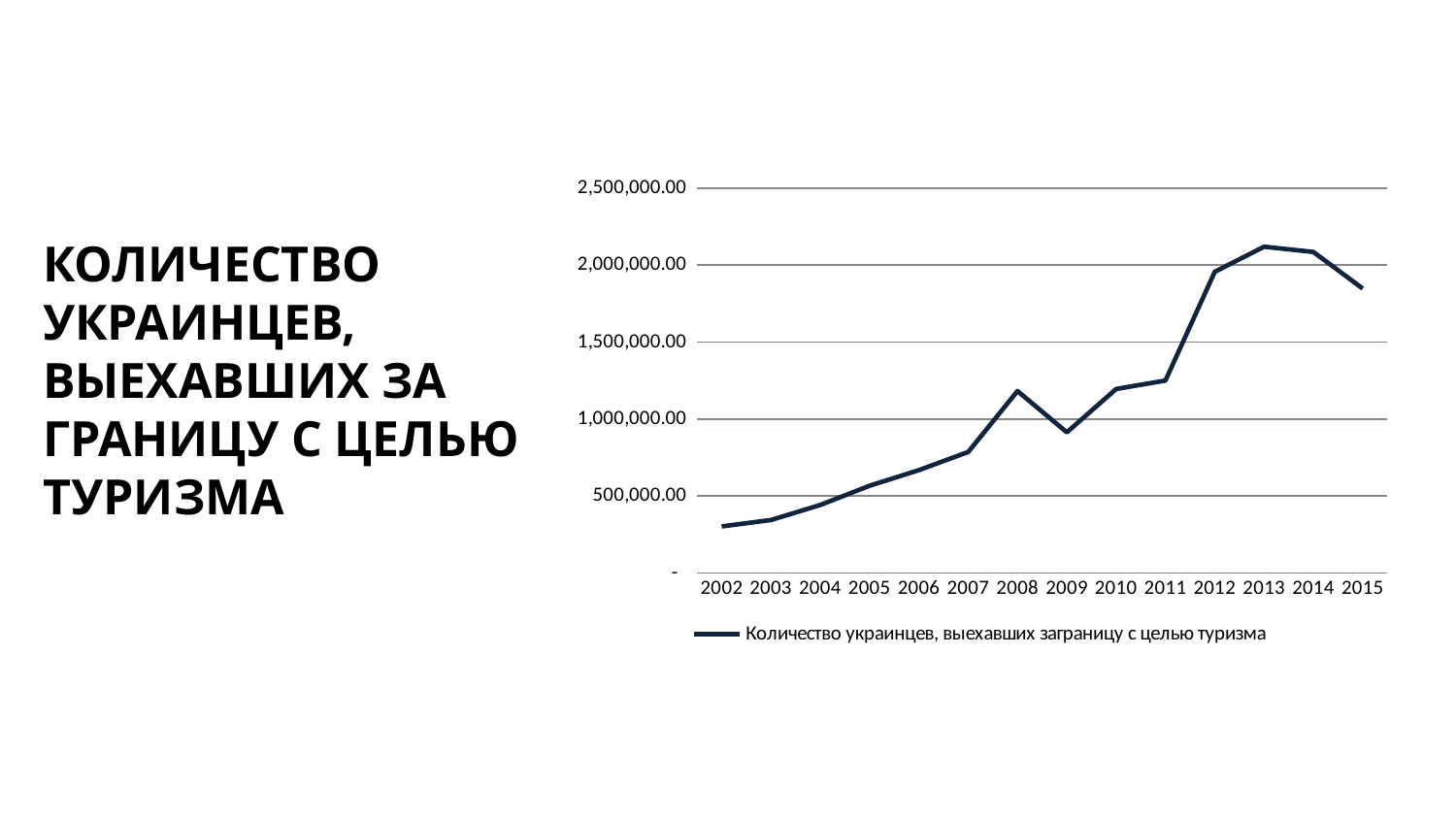
Is the value for 2008 greater or less than 1,000,000.00? greater Is the value for 2015 greater or less than 2,000,000.00? less Which year has the lowest value on the chart? 2002 What kind of chart is shown on the slide? line chart Is the value for 2002 greater or less than 500,000.00? less What is the legend entry for the plotted series? Количество украинцев, выехавших заграницу с целью туризма How many series does the chart's legend list? 1 Does the value generally rise or fall from 2002 to 2013? rise Which year has the larger value, 2008 or 2009? 2008 How many years are plotted along the x axis of the chart? 14